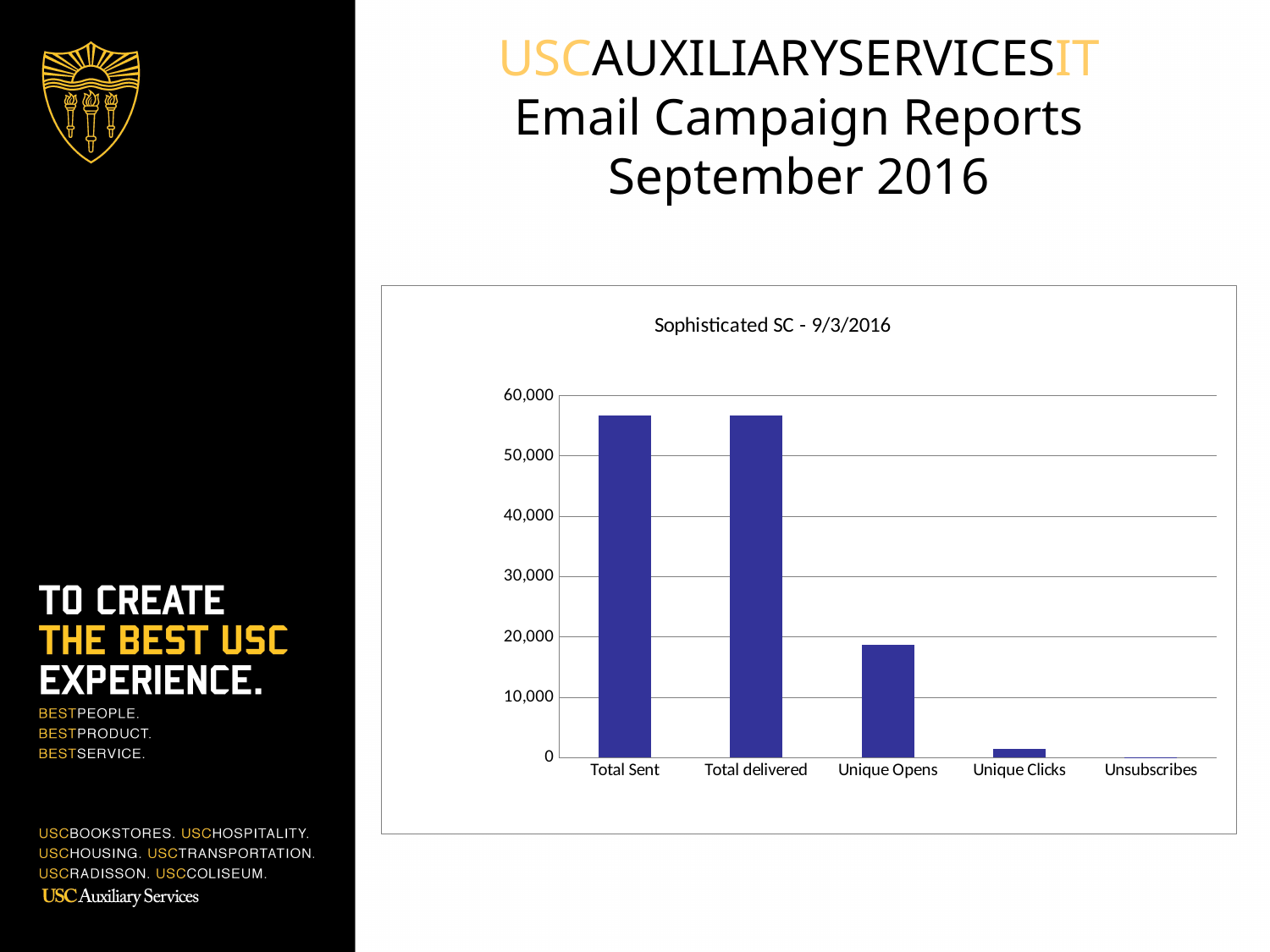
Which is larger, the value for Total delivered or the value for Unique Opens? Total delivered What is the title of the chart? Sophisticated SC - 9/3/2016 Is the value for Total Sent greater or less than 50,000? greater What kind of chart is shown on the slide? bar chart Is the value for Unique Opens greater or less than 10,000? greater Which category has the lowest value in the chart? Unsubscribes Which is larger, the value for Unique Opens or the value for Unique Clicks? Unique Opens Is the value for Unique Clicks greater or less than 10,000? less Do the values generally rise or fall moving from left to right along the x axis? fall How many categories are shown on the x axis of the chart? 5